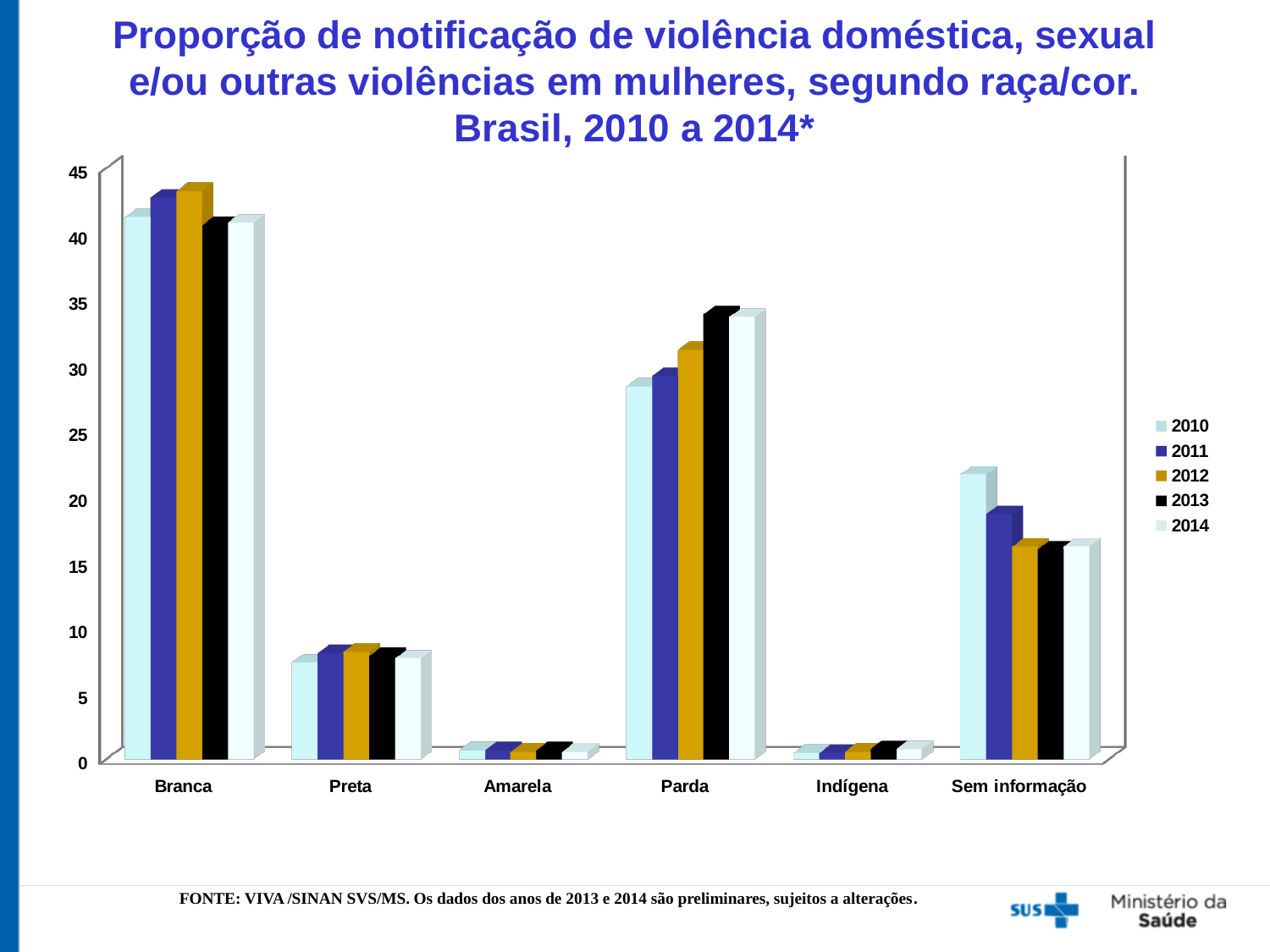
Do the values for Sem informação rise or fall from 2010 to 2013? fall Is the value for Sem informação in 2010 greater or less than 20? greater Which is larger, the value for Parda in 2010 or the value for Sem informação in 2010? Parda in 2010 Which years are listed in the legend? 2010, 2011, 2012, 2013, 2014 Is the value for Branca in 2012 greater or less than 40? greater What kind of chart is shown on the slide? bar chart How many series does the legend list? 5 How many race/colour categories are shown on the x axis? 6 Is the value for Parda in 2013 greater or less than 30? greater Which category has the highest values across all years? Branca Do the values for Parda rise or fall from 2010 to 2013? rise